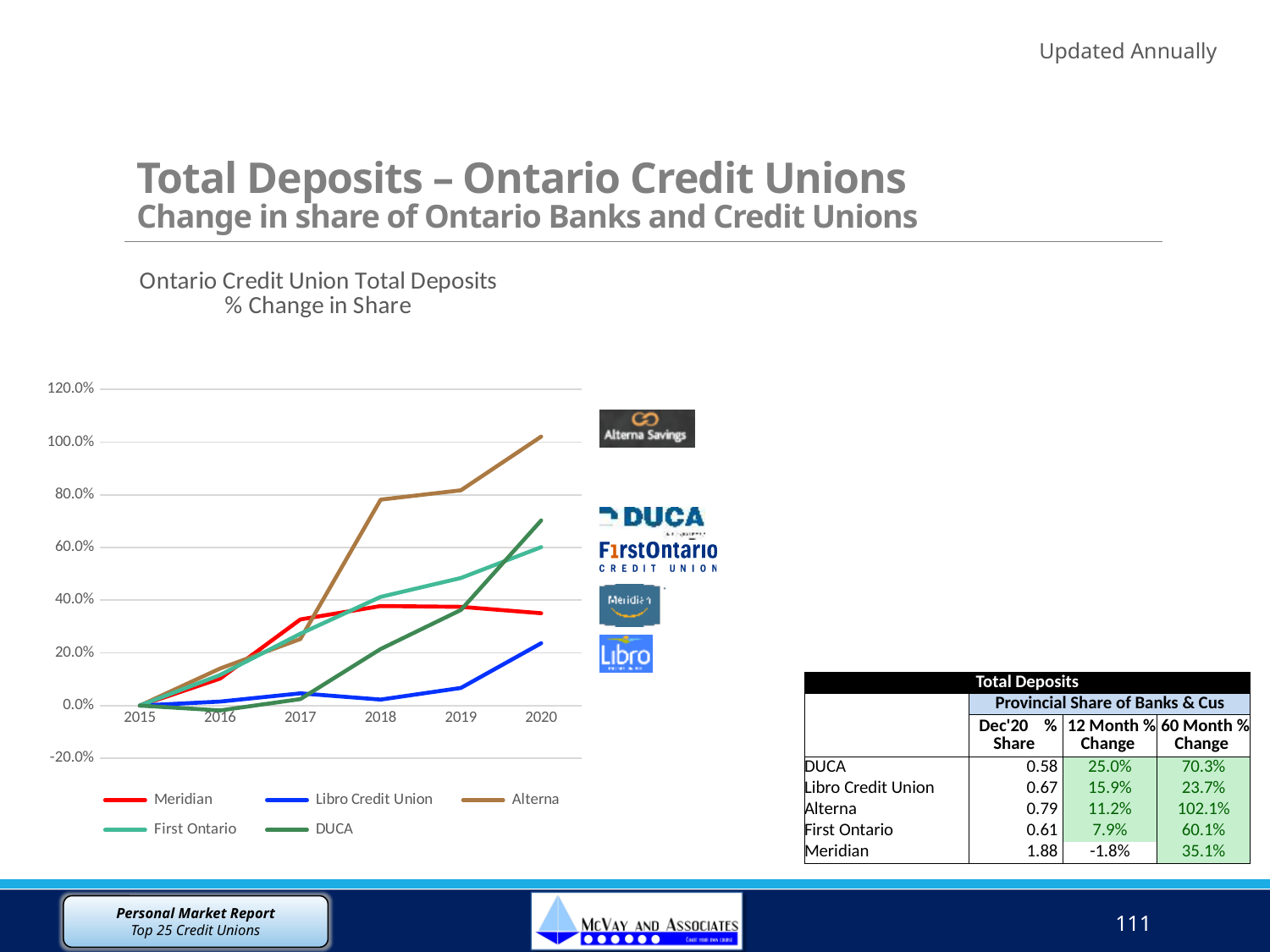
Does the Alterna line rise or fall from 2015 to 2020? rise In 2020, which is larger: the value for DUCA or the value for Meridian? DUCA Which credit union has the highest % change in share in 2020? Alterna Is the value for Libro Credit Union in 2020 greater or less than 20.0%? greater Which credit union has the lowest % change in share in 2020? Libro Credit Union What is the title of the chart? Ontario Credit Union Total Deposits % Change in Share Is the value for Alterna in 2020 greater or less than 80.0%? greater How many years are shown along the x axis of the chart? 6 Is the value for DUCA in 2020 greater or less than 60.0%? greater What kind of chart is shown on the slide? line chart How many series does the chart legend list? 5